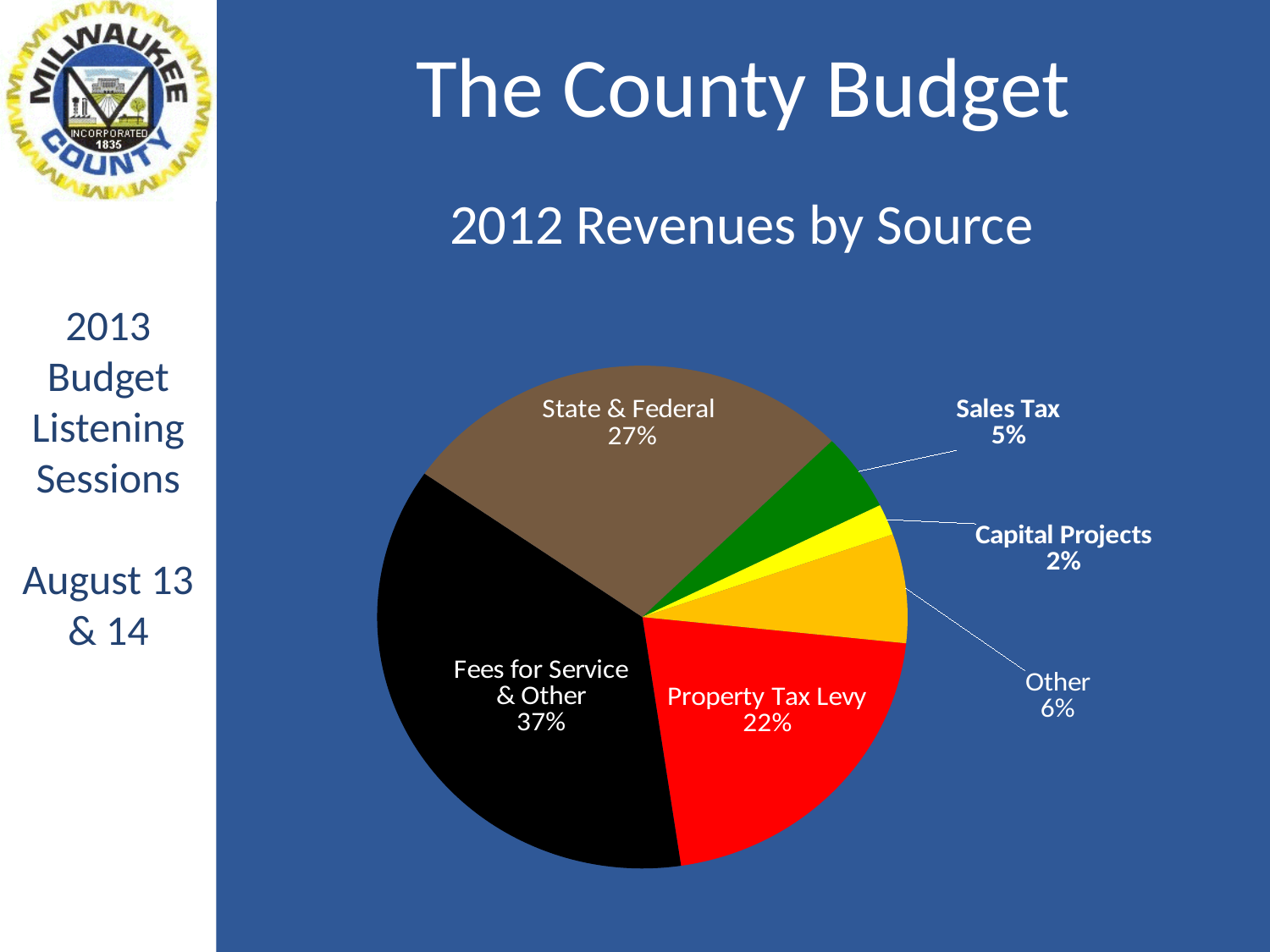
What share of 2012 revenues comes from Sales Tax? 5% What percentage of 2012 revenues comes from Capital Projects? 2% What share of 2012 revenues comes from Fees for Service & Other? 37% What colour is the Property Tax Levy slice? Red How many revenue sources are shown in the pie chart? 6 What share of 2012 revenues comes from State & Federal sources? 27% What kind of chart is used to show 2012 Revenues by Source? Pie chart Which revenue source has the smallest share of 2012 revenues? Capital Projects How many percentage points larger is the State & Federal share than the Property Tax Levy share? 5 Which revenue source has the largest share of 2012 revenues? Fees for Service & Other Which is larger, the share for Other or the share for Sales Tax? Other What percentage of 2012 revenues is the Property Tax Levy? 22%